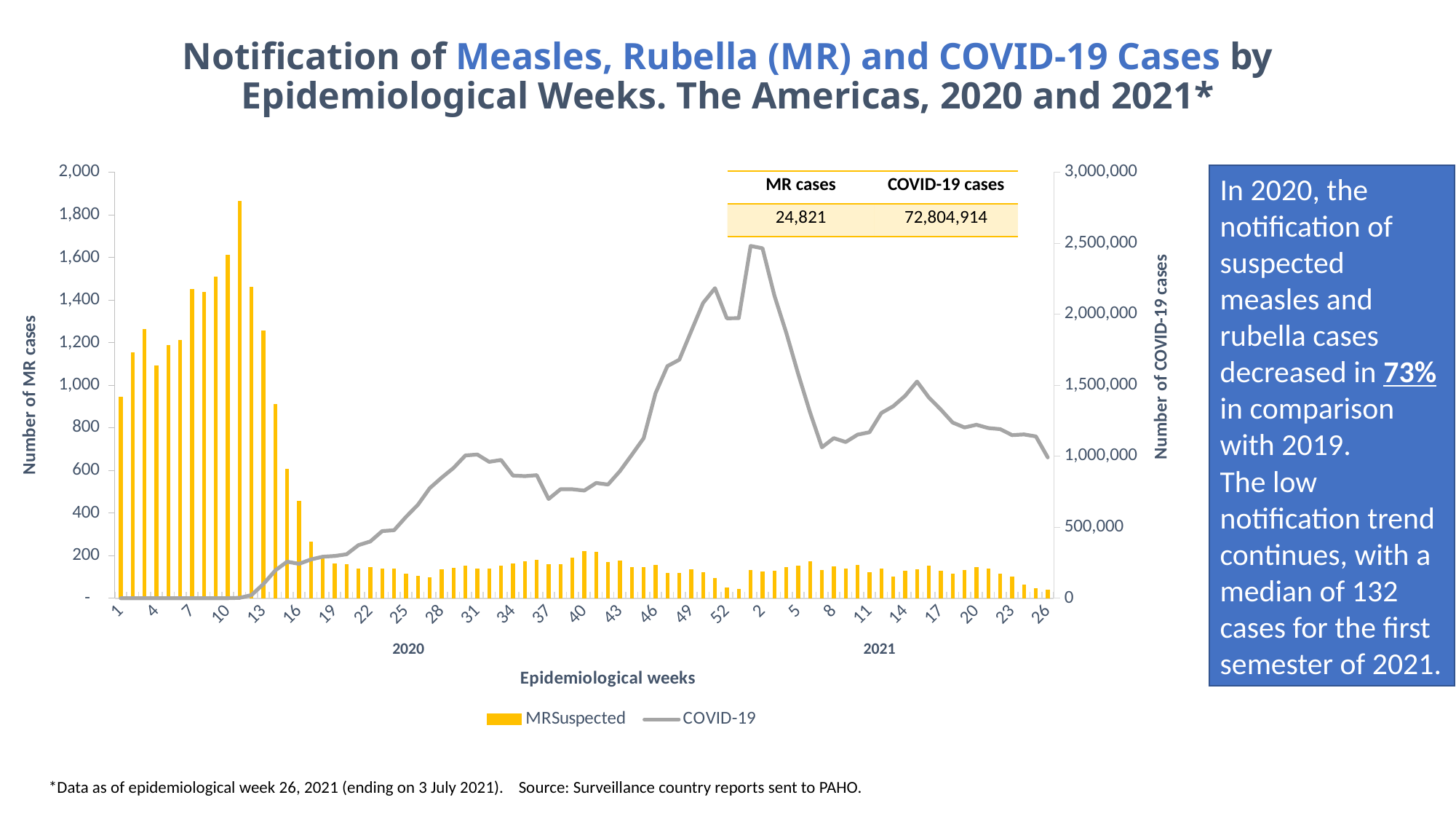
What kind of chart is shown on the slide? Combined bar and line chart According to the table on the chart, what is the total number of MR cases? 24,821 Which is larger, the MR suspected value at week 1 of 2020 or at week 1 of 2021? Week 1 of 2020 Is the COVID-19 value at week 26 of 2021 greater or less than 1,500,000? less Does the COVID-19 line rise or fall from week 1 to week 26 of 2020? rise What is the title of the right-hand vertical axis? Number of COVID-19 cases How many series does the chart legend list? 2 According to the table on the chart, what is the total number of COVID-19 cases? 72,804,914 Is the MR suspected value for week 1 of 2020 greater or less than 1,000? less Is the MR suspected value for week 10 of 2020 greater or less than 1,400? greater What are the two series named in the chart legend? MRSuspected and COVID-19